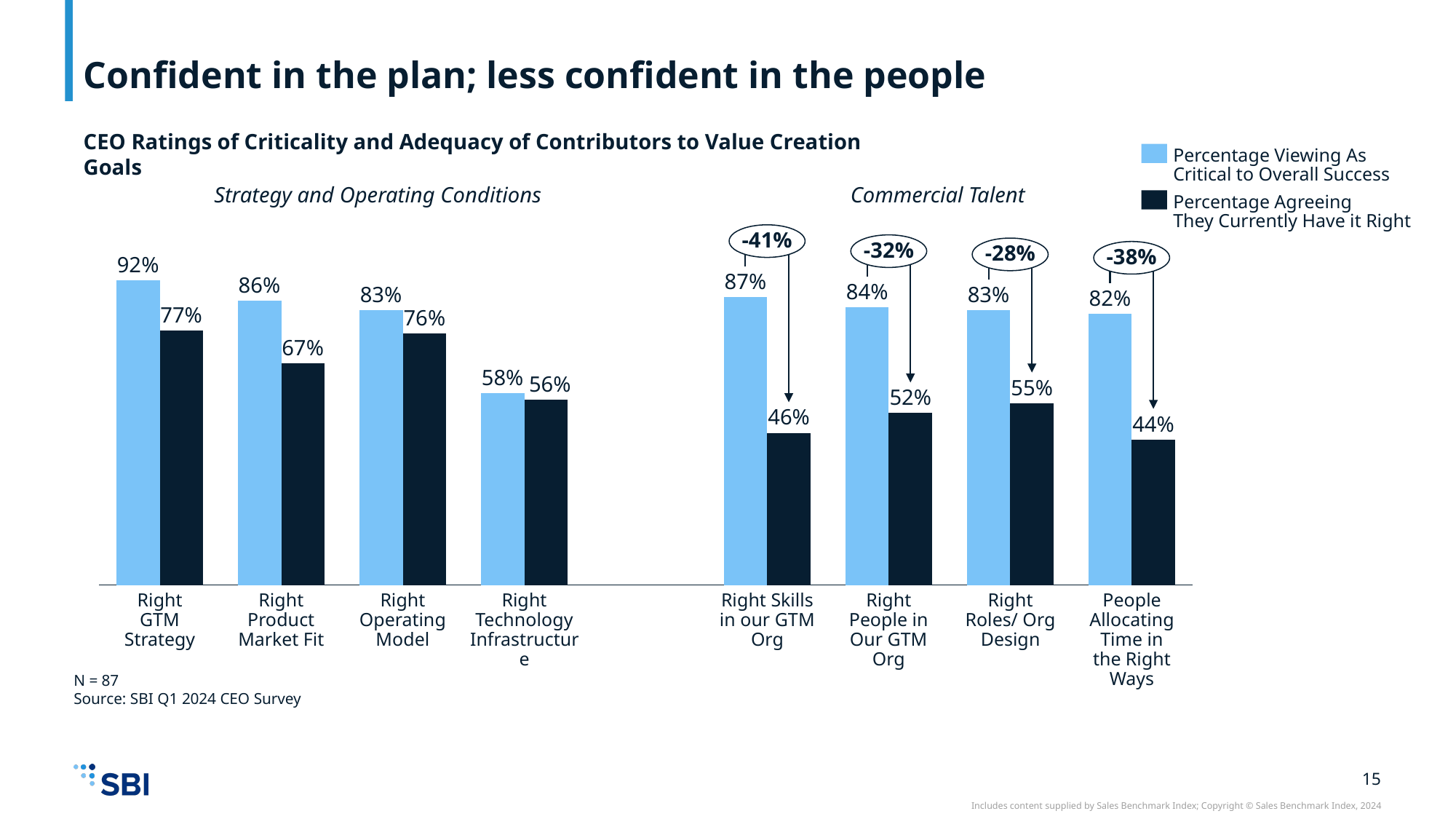
What percentage of CEOs agree they currently have Right Skills in our GTM Org right? 46% Which category has the highest percentage viewing it as critical to overall success? Right GTM Strategy What is the difference between the critical and currently-have-it-right percentages for Right Technology Infrastructure? 2% Which category has the lowest percentage agreeing they currently have it right? People Allocating Time in the Right Ways What is the sample size (N) noted below the chart? N = 87 How many series does the legend list? 2 Which is larger: the percentage agreeing they have the Right Operating Model right, or the percentage agreeing they have Right Roles/ Org Design right? Right Operating Model What percentage of CEOs agree they currently have the Right Product Market Fit? 67% How many categories are shown on the chart in total? 8 What is the difference between the percentage viewing Right People in Our GTM Org as critical and the percentage agreeing they have it right? 32% What percentage of CEOs view Right GTM Strategy as critical to overall success? 92% What kind of chart is shown on the slide? Bar chart